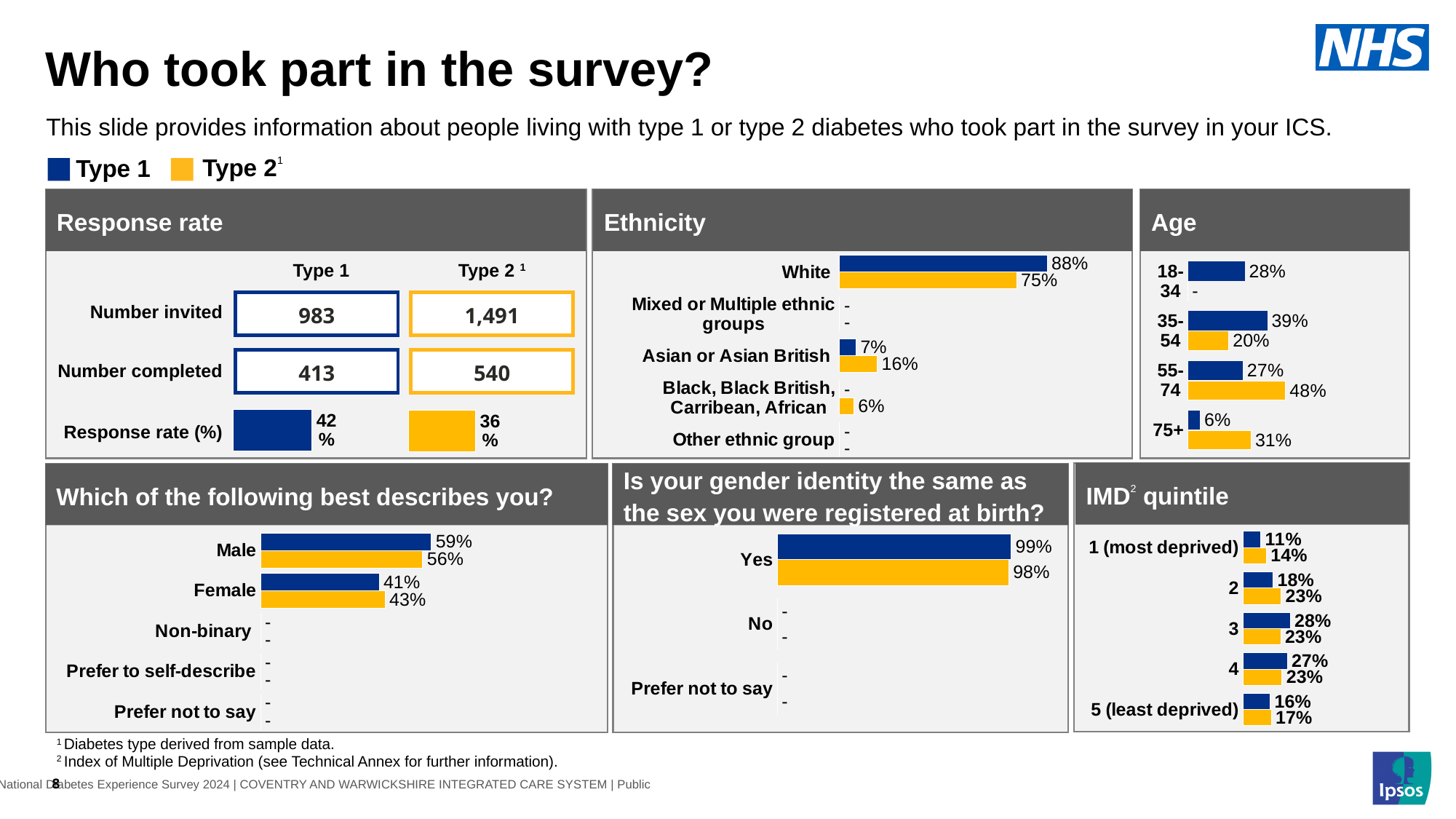
In the IMD quintile chart, what is the Type 1 value for quintile 3? 28% In the Ethnicity chart, which is larger for Asian or Asian British, the Type 1 value or the Type 2 value? Type 2 In the IMD quintile chart, which quintile has the lowest Type 1 value? 1 (most deprived) In the Age chart, what is the Type 2 value for the 55-74 age group? 48% In the 'Is your gender identity the same as the sex you were registered at birth?' chart, what is the Type 2 value for Yes? 98% In the Age chart, what is the difference between the Type 2 and Type 1 values for the 75+ age group? 25 percentage points In the 'Which of the following best describes you?' chart, what is the Type 1 value for Male? 59% In the Response rate panel, what is the response rate (%) for Type 1? 42% In the Ethnicity chart, what is the Type 1 value for White? 88% In the Response rate panel, what is the number completed for Type 2? 540 How many series does the legend at the top of the slide list? 2 In the Age chart, which age group has the highest Type 1 value? 35-54